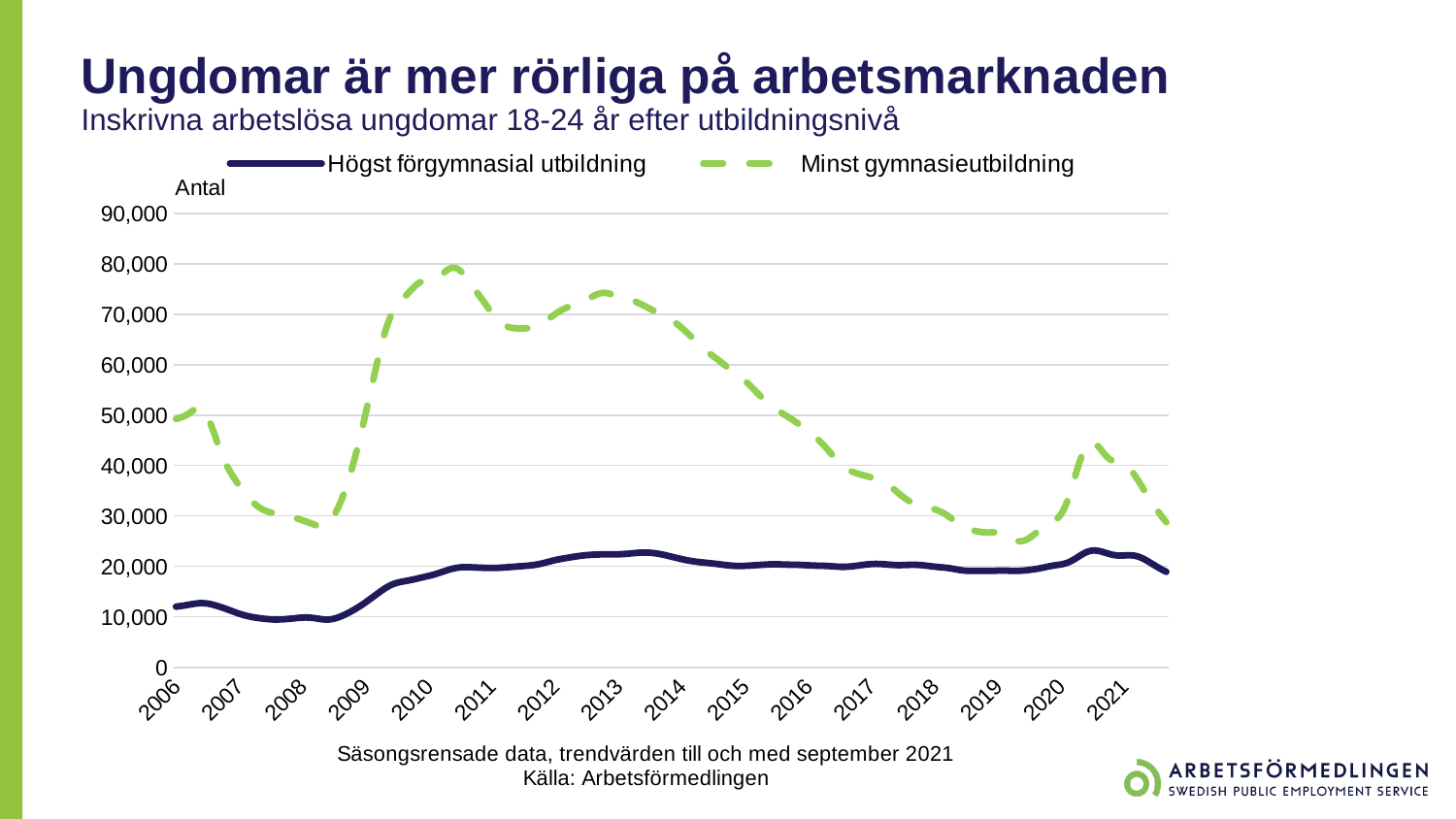
What is the label on the y axis of the chart? Antal Which series is drawn with a dashed green line? Minst gymnasieutbildning How many years are labelled on the x axis? 16 Is the value for Minst gymnasieutbildning in 2019 greater or less than 30,000? less Does the Minst gymnasieutbildning series rise or fall between 2013 and 2019? fall Does the Högst förgymnasial utbildning series rise or fall between 2008 and 2013? rise Is the value for Högst förgymnasial utbildning in 2013 greater or less than 20,000? greater Is the value for Högst förgymnasial utbildning in 2006 greater or less than 20,000? less What kind of chart is shown on the slide? Line chart Which series is higher in 2010, Högst förgymnasial utbildning or Minst gymnasieutbildning? Minst gymnasieutbildning How many series does the legend list? 2